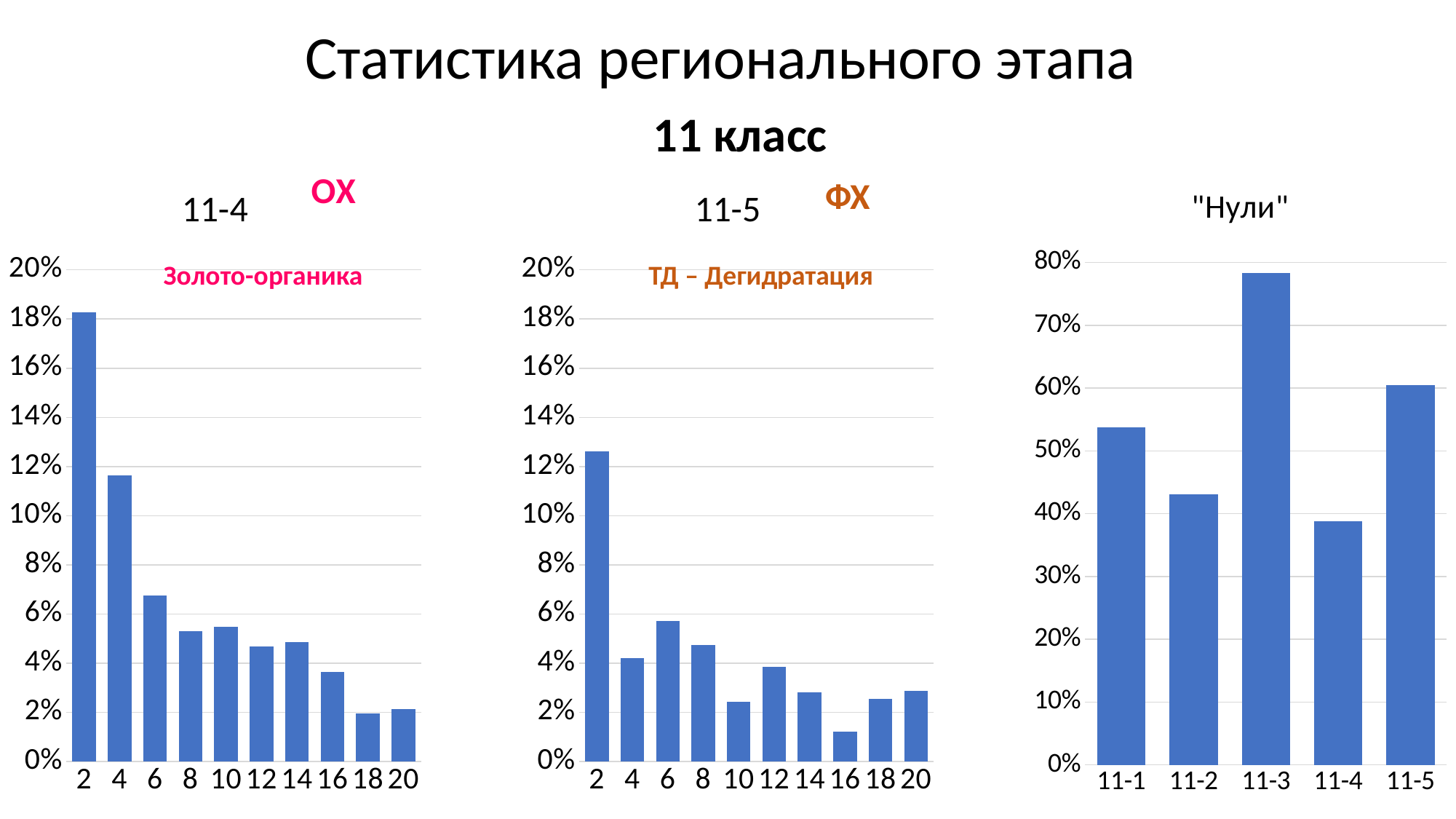
In the "11-5" chart, is the value for category 2 greater or less than 10%? greater In the "11-5" chart, which x-axis category has the lowest bar? 16 In the "11-5" chart, which is larger: the value for category 6 or the value for category 10? 6 What type of chart is the "Нули" chart? bar chart In the "11-4" chart, which x-axis category has the highest bar? 2 In the "11-5" chart, which x-axis category has the highest bar? 2 In the "Нули" chart, which category has the lowest bar? 11-4 In the "11-4" chart, is the value for category 16 greater or less than 4%? less How many bars are plotted in the "11-4" chart? 10 In the "11-4" chart, is the value for category 2 greater or less than 16%? greater In the "Нули" chart, which category has the highest bar? 11-3